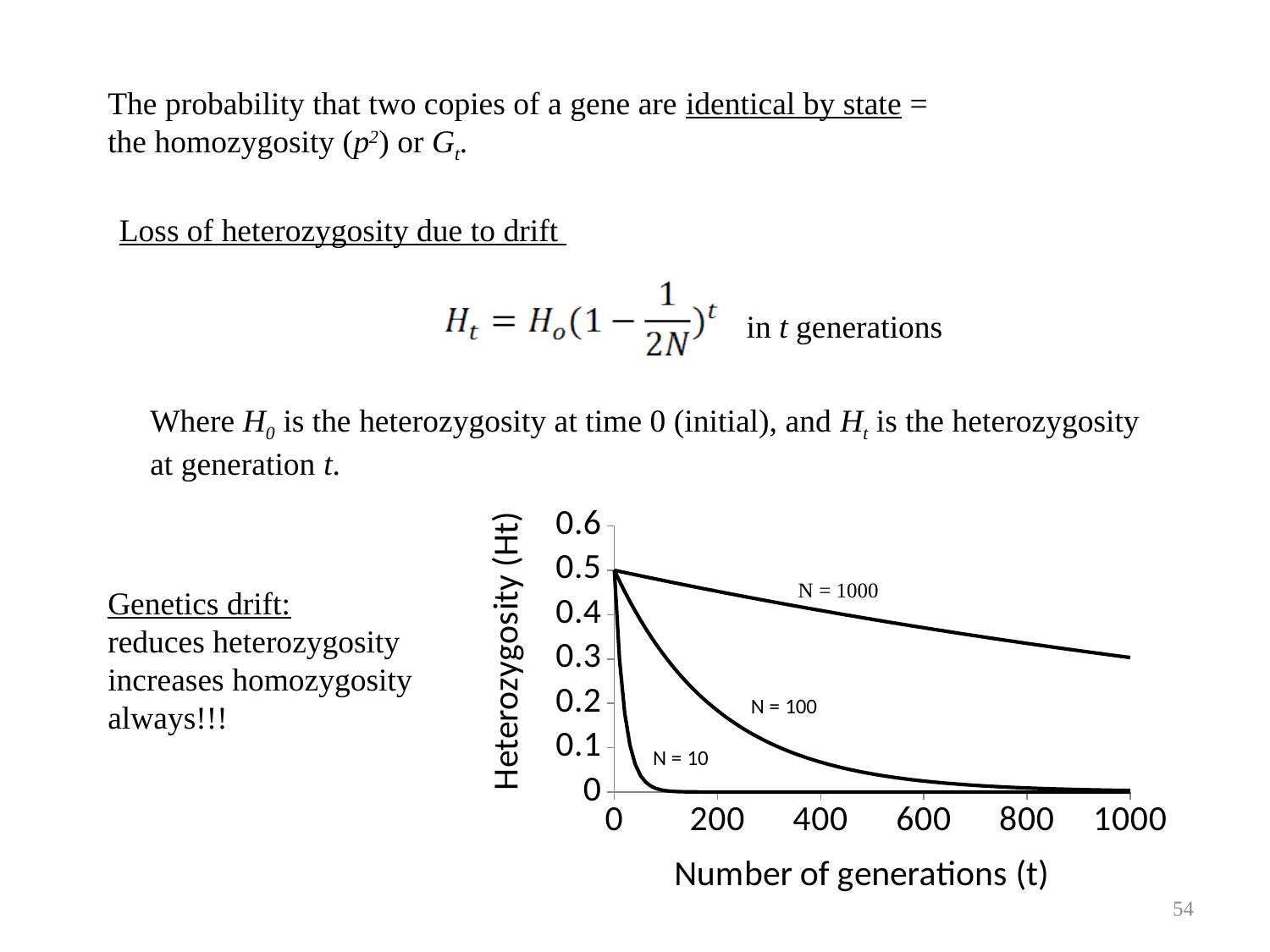
What is the title of the y axis of the chart? Heterozygosity (Ht) Which curve drops to near zero heterozygosity fastest? N = 10 How many curves are plotted on the chart? 3 What is the title of the x axis of the chart? Number of generations (t) Is the heterozygosity for the N = 100 curve at 400 generations greater or less than 0.1? less Which curve has the highest heterozygosity at 1000 generations? N = 1000 What is the heterozygosity value of the curves at generation 0? 0.5 Do the heterozygosity values rise or fall as the number of generations increases? fall Is the heterozygosity for the N = 1000 curve at 600 generations greater or less than 0.3? greater What kind of chart is shown on the slide? line chart At 400 generations, which curve has the higher heterozygosity, N = 1000 or N = 100? N = 1000 Is the heterozygosity for the N = 10 curve at 200 generations greater or less than 0.1? less